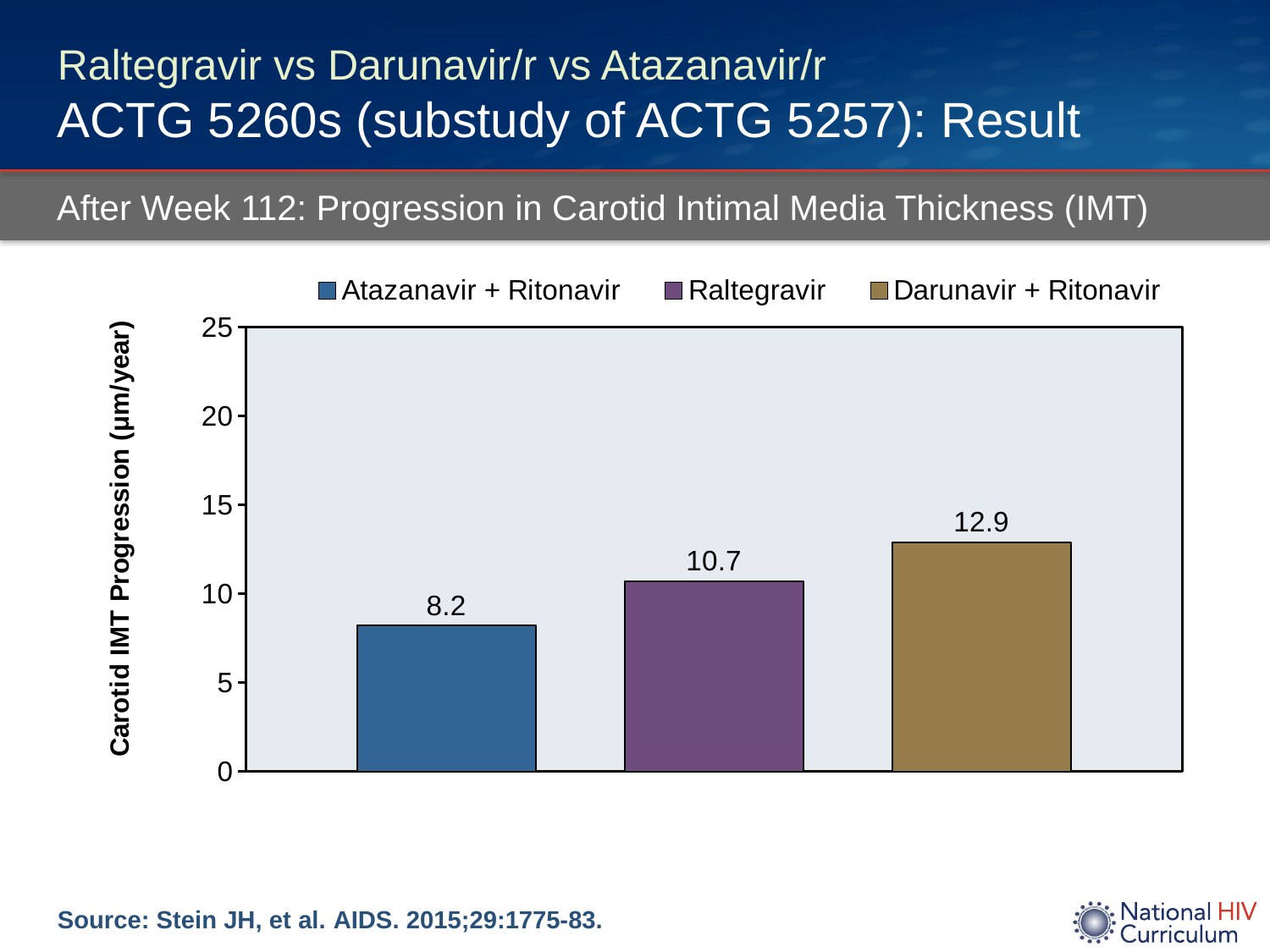
Which has a larger carotid IMT progression value, Raltegravir or Darunavir + Ritonavir? Darunavir + Ritonavir What is the difference in carotid IMT progression between Raltegravir and Atazanavir + Ritonavir? 2.5 Which treatment group has the lowest carotid IMT progression? Atazanavir + Ritonavir What is the carotid IMT progression value for Raltegravir? 10.7 What is the carotid IMT progression value for Darunavir + Ritonavir? 12.9 How many treatment groups are shown in the chart? 3 What is the difference in carotid IMT progression between Darunavir + Ritonavir and Atazanavir + Ritonavir? 4.7 Which treatment group has the highest carotid IMT progression? Darunavir + Ritonavir What is the carotid IMT progression value for Atazanavir + Ritonavir? 8.2 What kind of chart is shown on the slide? Bar chart Is the carotid IMT progression value for Atazanavir + Ritonavir greater or less than 10? less What is the label of the y-axis of the chart? Carotid IMT Progression (µm/year)